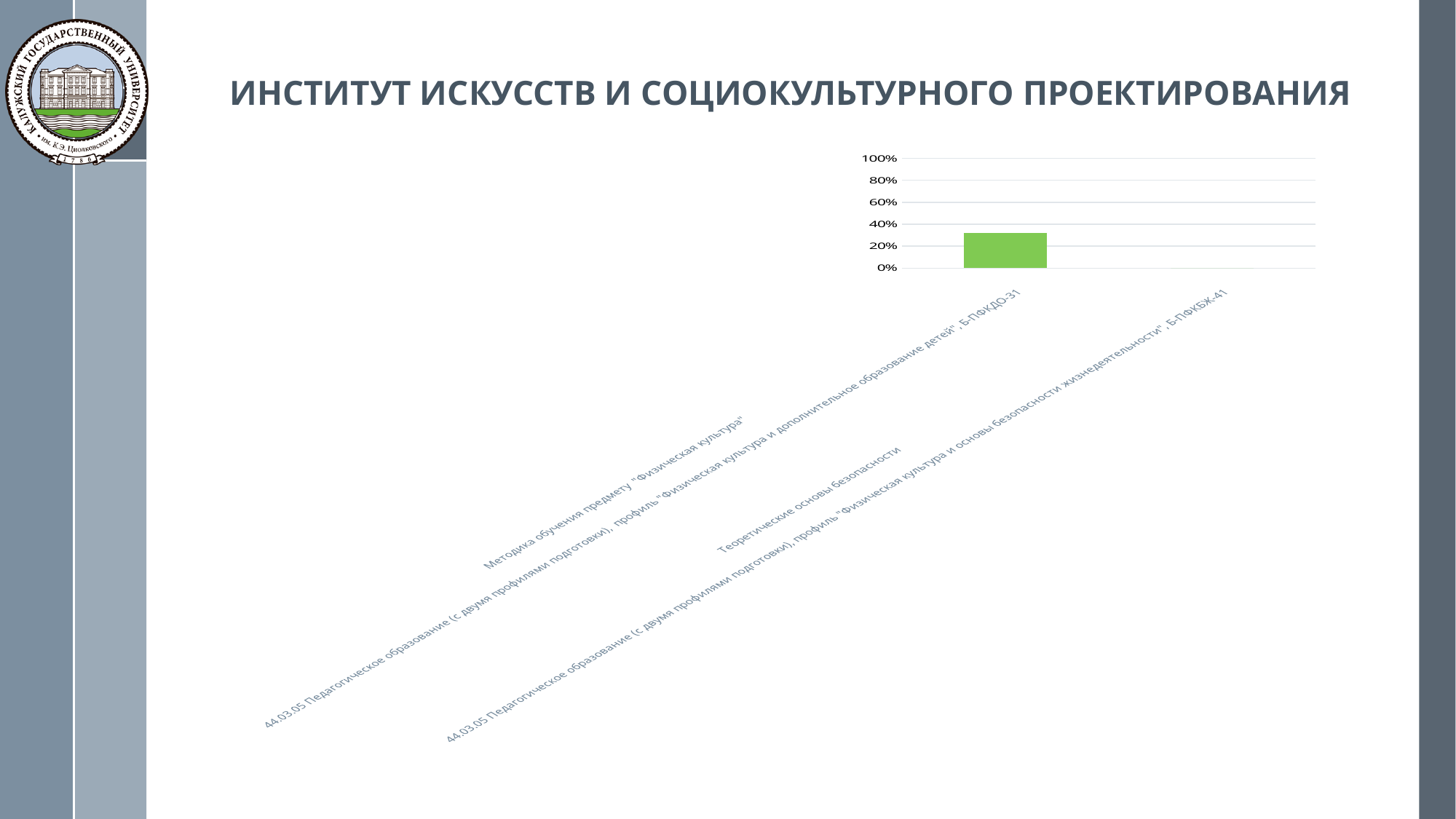
Do the values rise or fall from the first category to the second along the x axis? fall Which category has the lowest value on the chart? Теоретические основы безопасности, Б-ПФКБЖ-41 Which category has the highest value on the chart? Методика обучения предмету "Физическая культура", Б-ПФКДО-31 Is the value for the group Б-ПФКБЖ-41 (Теоретические основы безопасности) greater or less than 20%? less Is the value for the group Б-ПФКДО-31 (Методика обучения предмету "Физическая культура") greater or less than 20%? greater Is the value for the group Б-ПФКДО-31 (Методика обучения предмету "Физическая культура") greater or less than 40%? less What kind of chart is shown on the slide? bar chart What colour are the bars in the chart? green Which group has the larger value: Б-ПФКДО-31 or Б-ПФКБЖ-41? Б-ПФКДО-31 How many categories are plotted on the chart? 2 What is the highest tick value shown on the vertical axis of the chart? 100%